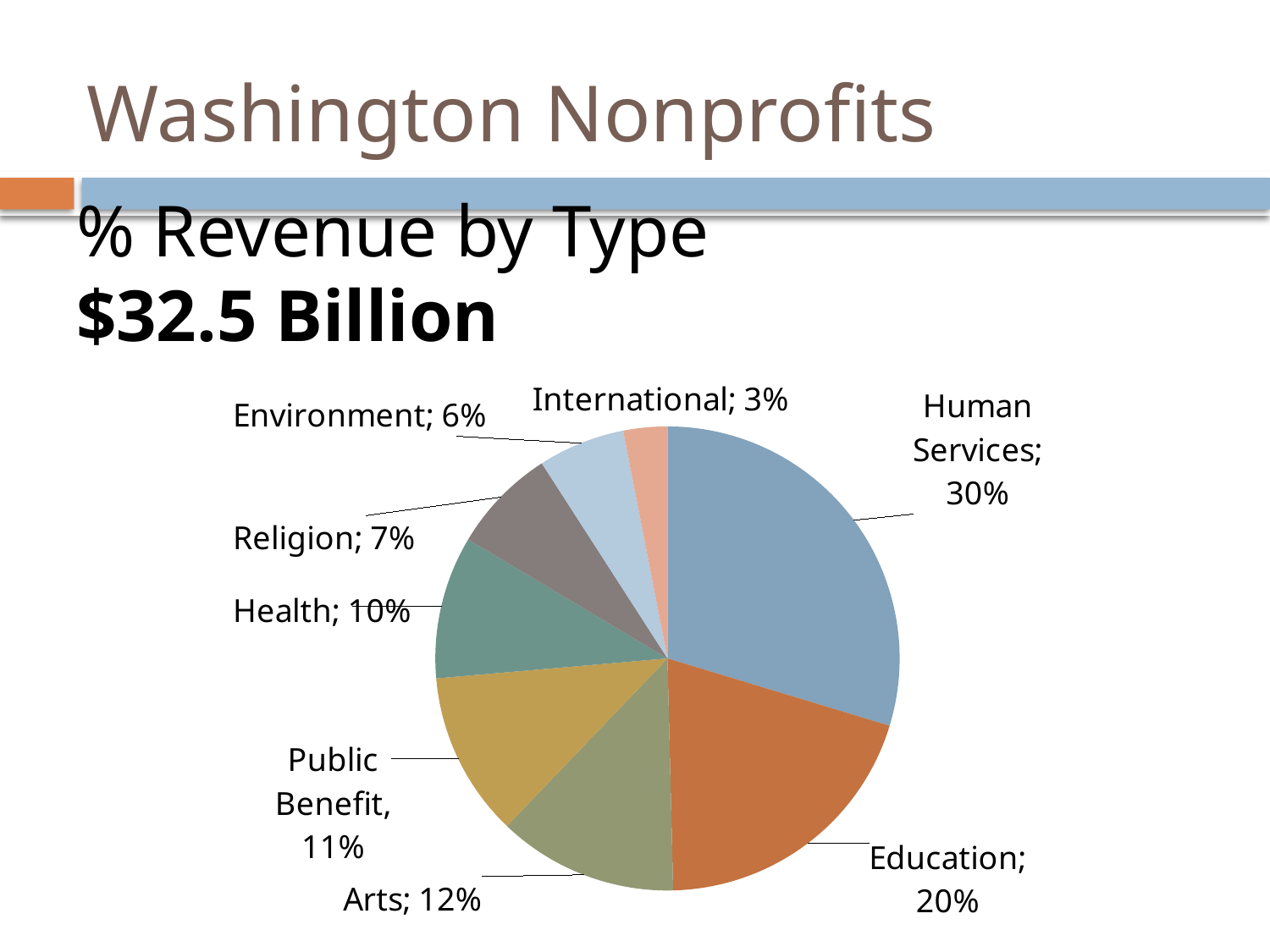
How many slices does the pie chart have? 8 What total revenue amount is stated above the chart? $32.5 Billion What percentage of revenue comes from Arts? 12% What kind of chart is shown on the slide? pie chart What percentage of revenue comes from Human Services? 30% What is the difference in percentage points between Human Services and Education? 10 Which type has the smallest share of revenue? International Which type has the largest share of revenue? Human Services What percentage of revenue comes from Religion? 7% What is the difference in percentage points between Environment and International? 3 Which has a larger share of revenue, Health or Public Benefit? Public Benefit What percentage of revenue comes from Education? 20%